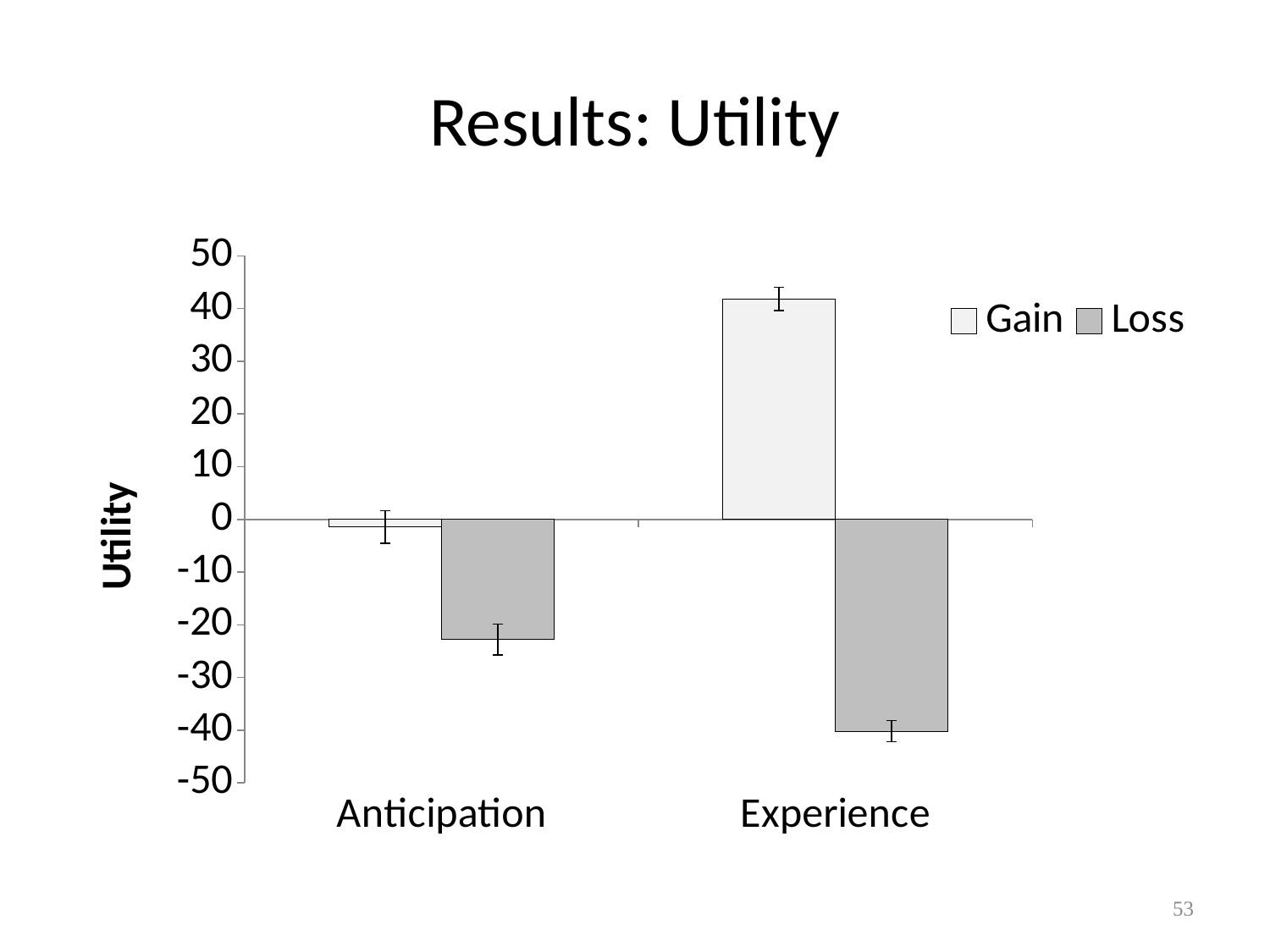
Is the Loss value for Experience greater or less than -30? less How many categories are shown on the x axis of the chart? 2 How many series does the chart's legend list? 2 Is the Loss value for Anticipation greater or less than -10? less What kind of chart is shown on the slide? bar chart Which is larger, the Loss value for Anticipation or the Loss value for Experience? Loss value for Anticipation What is the label on the vertical axis of the chart? Utility Which series and category has the lowest value in the chart? Loss, Experience Which is larger, the Gain value for Experience or the Gain value for Anticipation? Gain value for Experience Is the Gain value for Experience greater or less than 30? greater Which series and category has the highest value in the chart? Gain, Experience